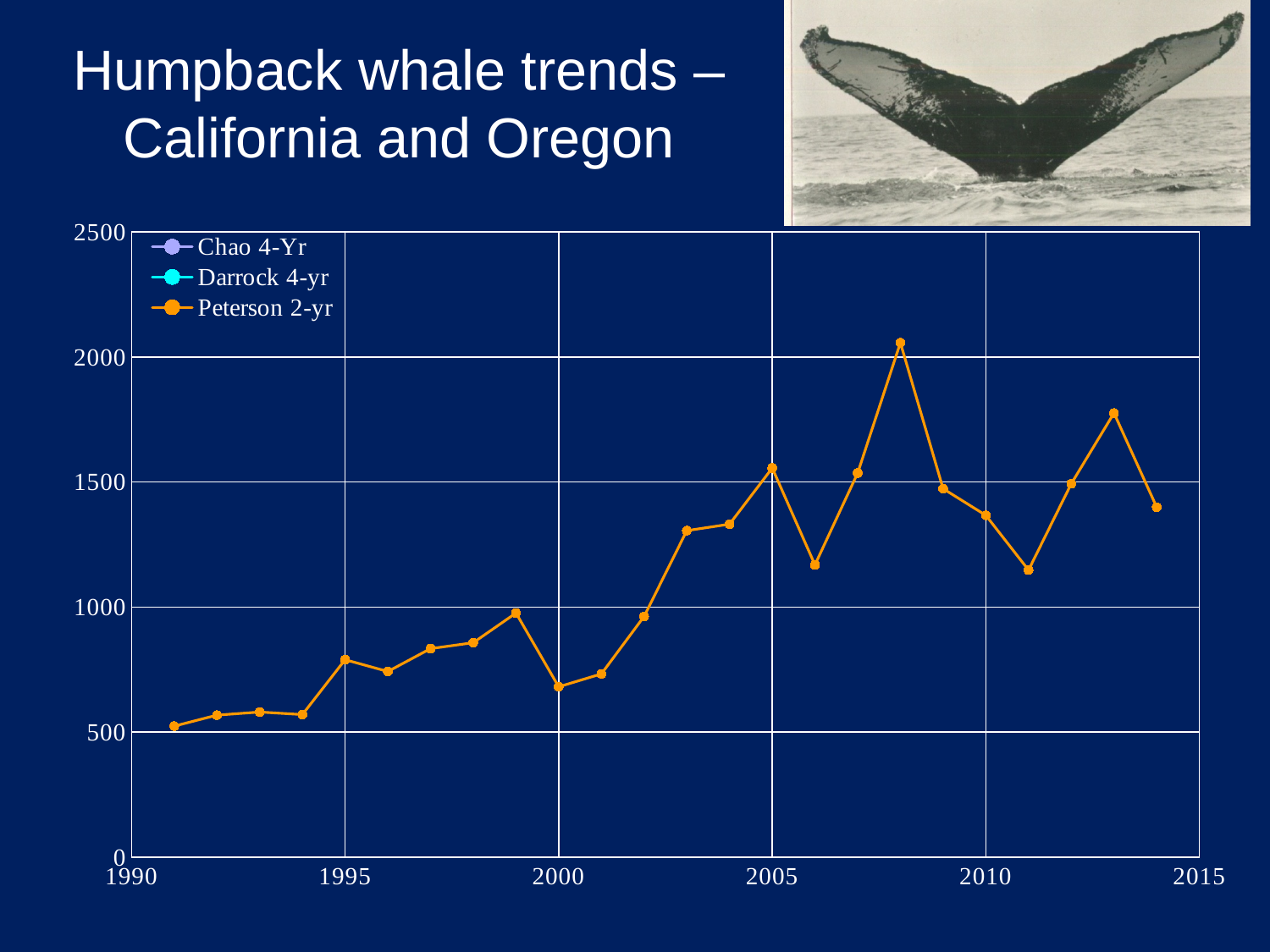
Overall, does the Peterson 2-yr series rise or fall from 1991 to 2014? rise Is the Peterson 2-yr value for 2013 greater or less than 1500? greater What kind of chart is shown on the slide? line chart Is the Peterson 2-yr value for 2000 greater or less than 1000? less Which year has the larger Peterson 2-yr value, 2005 or 2006? 2005 Which series is plotted in orange? Peterson 2-yr Which year has the larger Peterson 2-yr value, 2008 or 2013? 2008 Is the Peterson 2-yr value for 1991 greater or less than 1000? less In which year does the Peterson 2-yr series have its lowest value? 1991 In which year does the Peterson 2-yr series reach its highest value? 2008 How many series does the legend list? 3